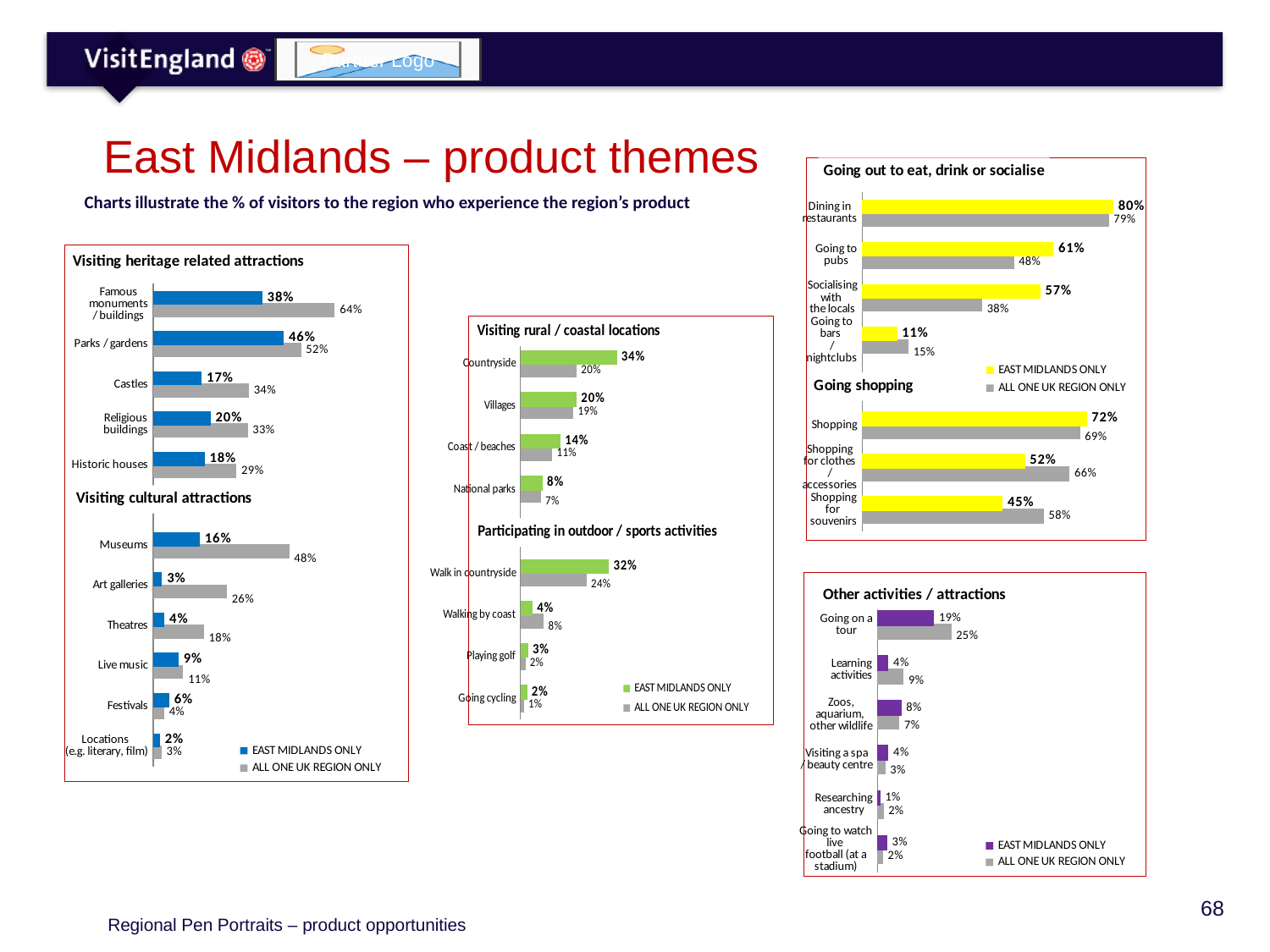
How many series does the legend of the 'Other activities / attractions' chart list? 2 What type of chart is the 'Going shopping' chart? Bar chart In the 'Visiting heritage related attractions' chart, what is the All one UK region only value for Famous monuments / buildings? 64% In the 'Participating in outdoor / sports activities' chart, which category has the lowest East Midlands only value? Going cycling In the 'Visiting cultural attractions' chart, which category has the highest East Midlands only value? Museums In the 'Going out to eat, drink or socialise' chart, which is larger for Socialising with the locals: the East Midlands only value or the All one UK region only value? East Midlands only In the 'Other activities / attractions' chart, how many categories are shown? 6 In the 'Visiting rural / coastal locations' chart, what is the East Midlands only value for Countryside? 34% In the 'Going out to eat, drink or socialise' chart, what is the East Midlands only value for Going to pubs? 61% In the 'Going shopping' chart, what is the All one UK region only value for Shopping for souvenirs? 58% In the 'Visiting cultural attractions' chart, what is the difference between the All one UK region only value and the East Midlands only value for Museums? 32% In the 'Visiting heritage related attractions' chart, what is the East Midlands only value for Parks / gardens? 46%